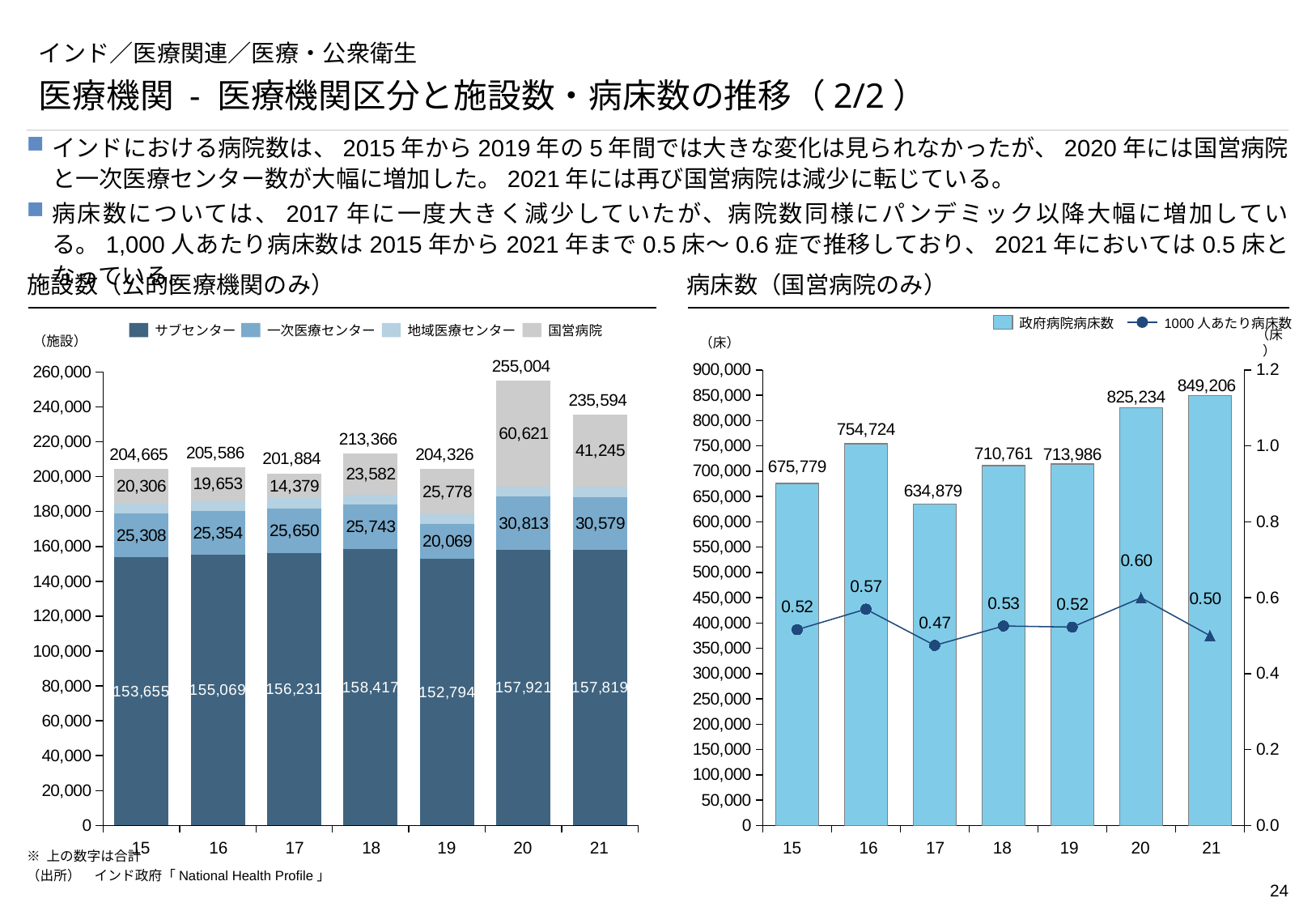
In the 施設数（公的医療機関のみ） chart on the left, what is the total number of facilities in 2020 (20)? 255,004 In the 施設数（公的医療機関のみ） chart on the left, which year has the lowest total number of facilities? 17 In the 病床数（国営病院のみ） chart on the right, how many series does the legend list? 2 In the 施設数（公的医療機関のみ） chart on the left, what is the value for サブセンター in 2019 (19)? 152,794 In the 病床数（国営病院のみ） chart on the right, which year has the lowest number of government hospital beds? 17 In the 病床数（国営病院のみ） chart on the right, which year has the highest 1000人あたり病床数 value? 20 In the 施設数（公的医療機関のみ） chart on the left, what is the value for 国営病院 in 2021 (21)? 41,245 In the 病床数（国営病院のみ） chart on the right, what is the number of government hospital beds in 2021 (21)? 849,206 In the 病床数（国営病院のみ） chart on the right, by how much did the number of beds increase from 2020 (20) to 2021 (21)? 23,972 In the 病床数（国営病院のみ） chart on the right, what is the value of 1000人あたり病床数 in 2017 (17)? 0.47 In the 施設数（公的医療機関のみ） chart on the left, how many series does the legend list? 4 In the 施設数（公的医療機関のみ） chart on the left, is the value for 一次医療センター larger in 2020 (20) or in 2021 (21)? 2020 (20)